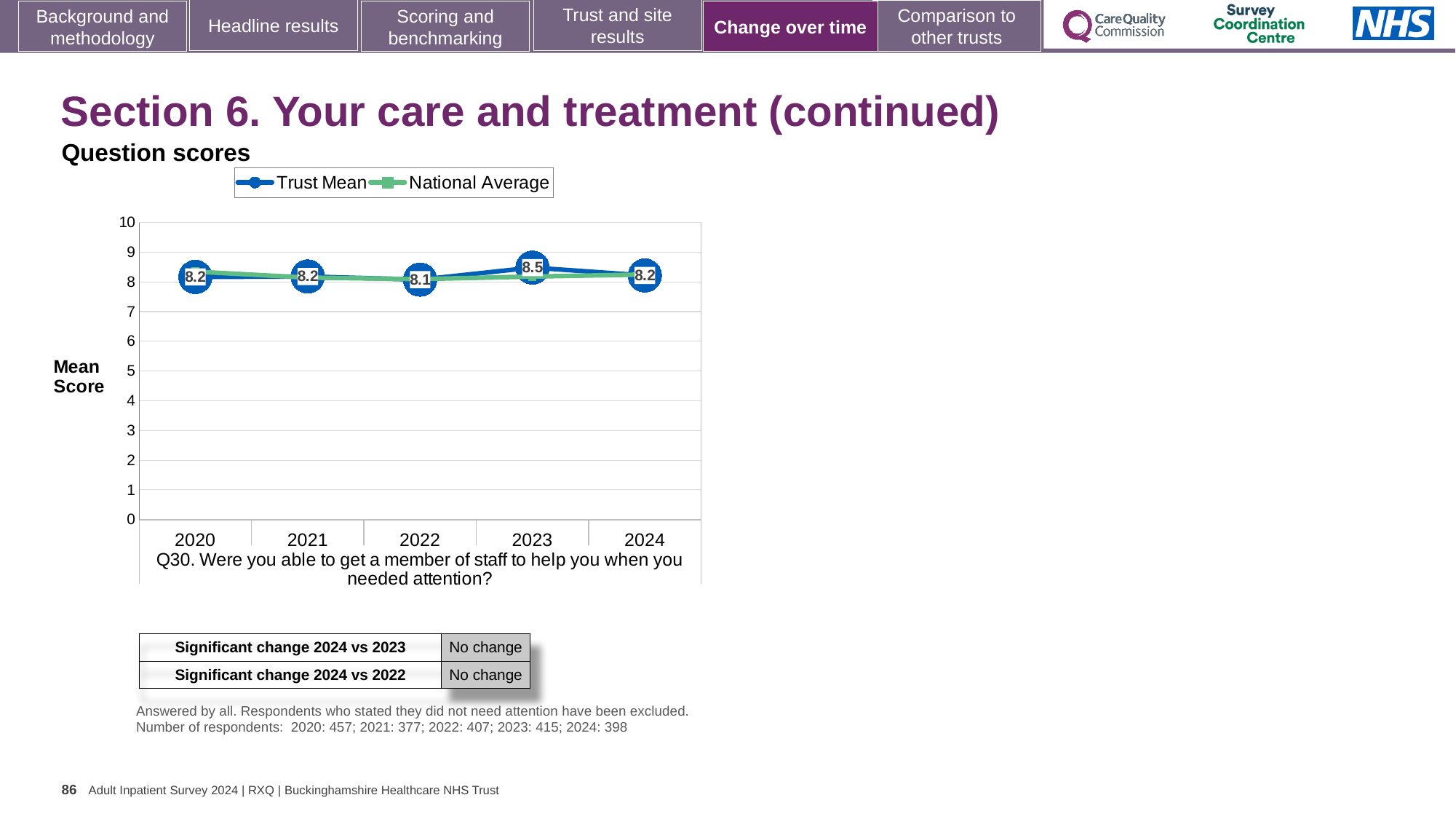
What is the difference between the Trust Mean score in 2023 and in 2022? 0.4 What kind of chart is shown? Line chart How many series does the legend list? 2 How many years are plotted on the x axis? 5 What is the Trust Mean score for 2022? 8.1 Is the National Average value for 2024 greater or less than 5? greater Between 2022 and 2023, did the Trust Mean score rise or fall? rise Which is larger, the Trust Mean score in 2023 or in 2024? 2023 In which year is the Trust Mean score lowest? 2022 What is the Trust Mean score for 2023? 8.5 In which year is the Trust Mean score highest? 2023 What is the Trust Mean score for 2020? 8.2